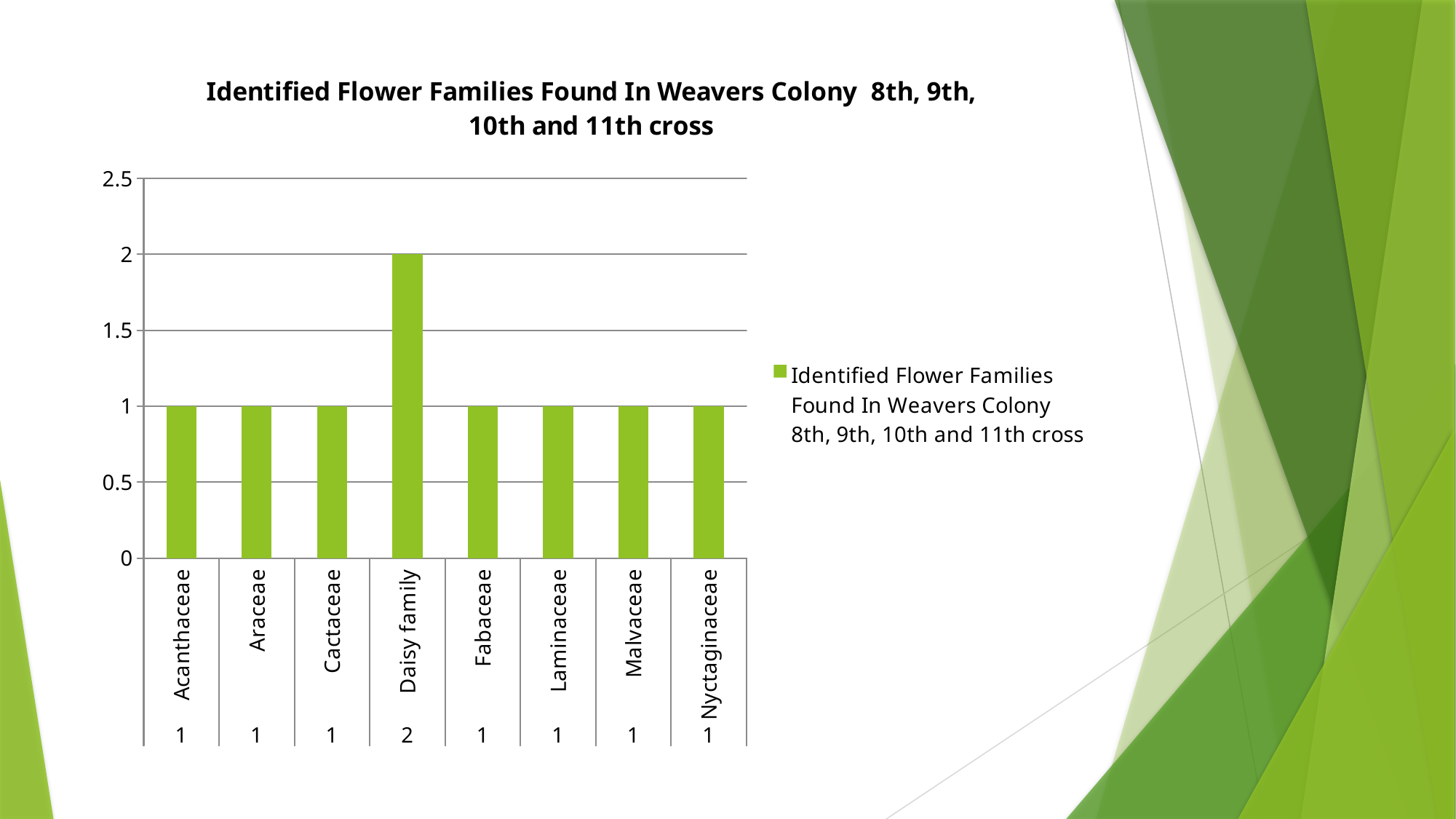
Is the value for Daisy family greater or less than 1.5? greater How many flower families are shown on the x axis? 8 Which flower family has the highest value? Daisy family What is the value for Malvaceae? 1 What is the difference between the values for Daisy family and Fabaceae? 1 What is the title of the chart? Identified Flower Families Found In Weavers Colony 8th, 9th, 10th and 11th cross What is the value for Daisy family? 2 What kind of chart is shown on the slide? bar chart How many series does the legend list? 1 What colour are the bars in the chart? green Which is larger, the value for Daisy family or the value for Cactaceae? Daisy family What is the value for Acanthaceae? 1